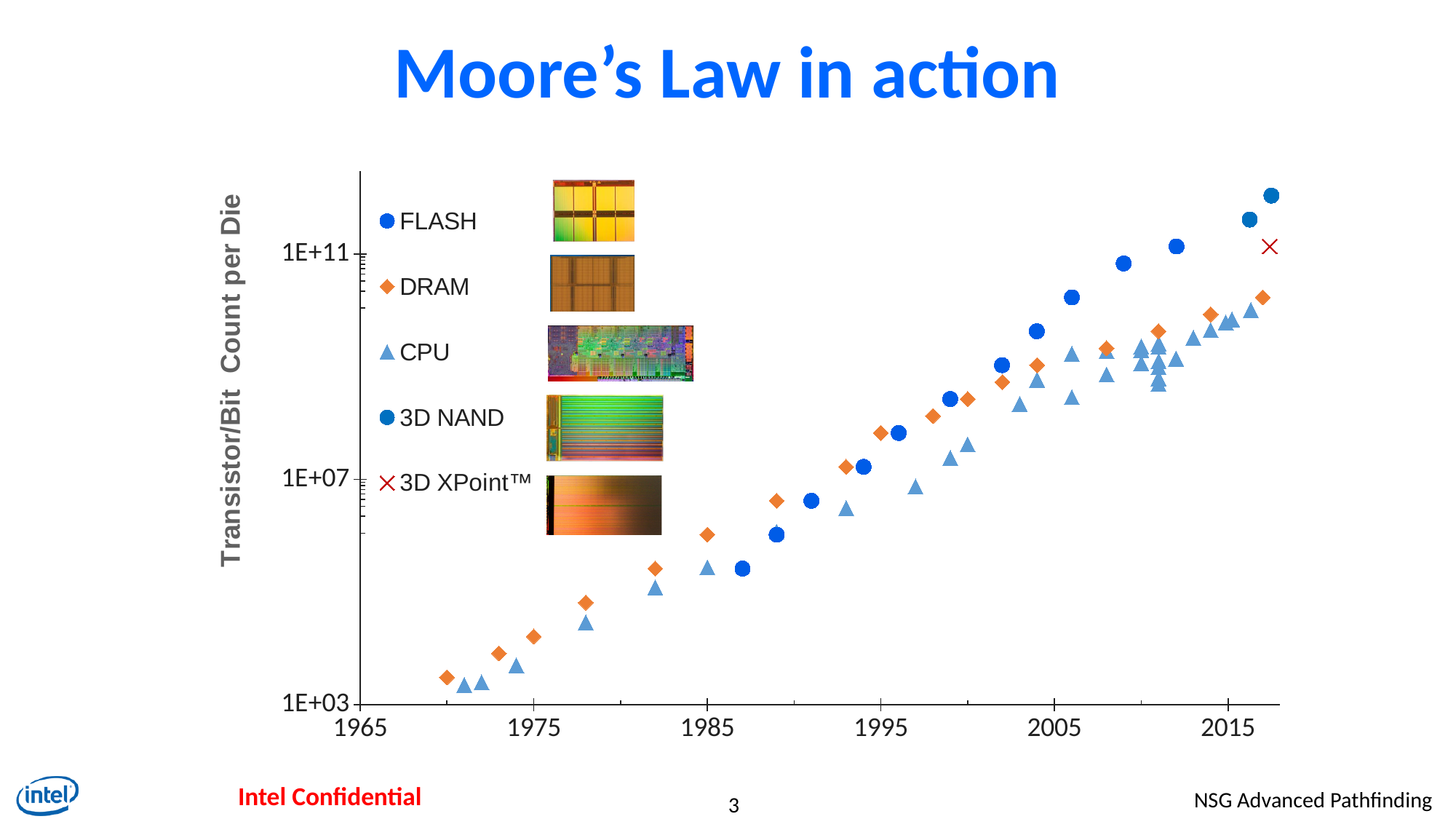
Is the CPU value plotted at 1985 greater or less than 1E+07? less How many series does the legend list? 5 How many 3D XPoint points are plotted on the chart? 1 Is the DRAM value plotted at about 1995 greater or less than 1E+07? greater Is the highest 3D NAND point greater or less than 1E+11? greater Do the plotted values rise or fall as the year increases along the x axis? rise Which series has the highest plotted point on the chart? 3D NAND What is the title of the chart? Moore's Law in action At about 2017, which is larger: the 3D NAND value or the DRAM value? 3D NAND What is the label of the y axis? Transistor/Bit Count per Die What kind of chart is shown on the slide? scatter chart